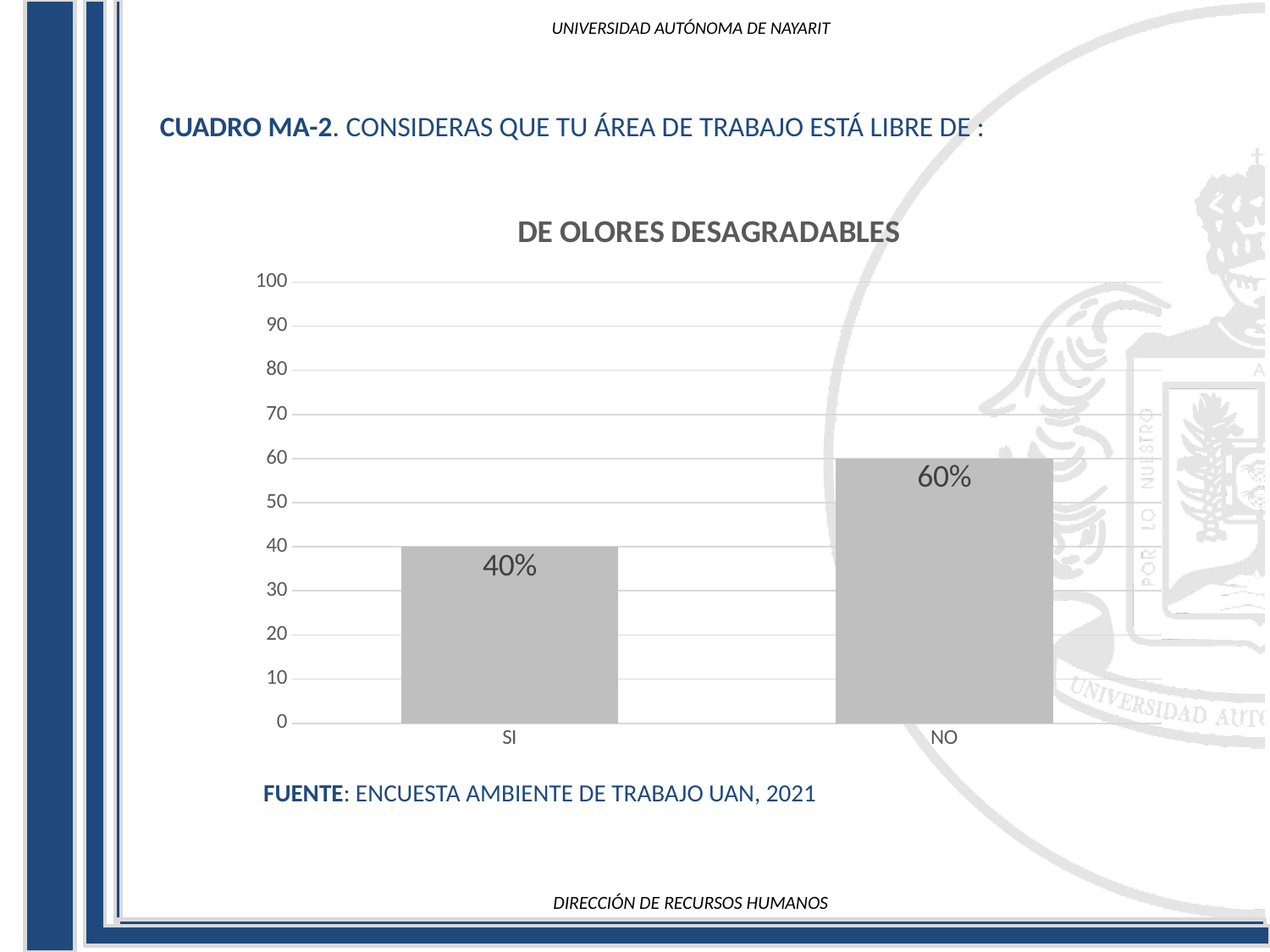
Is the value for SI greater or less than 50? less How many categories are shown on the x axis? 2 Which is larger, the value for SI or the value for NO? NO What is the difference between the values for NO and SI? 20% What kind of chart is shown on the slide? bar chart Which category has the highest value? NO Which category has the lowest value? SI Is the value for NO greater or less than 50? greater What is the value for SI? 40% What is the title of the chart? DE OLORES DESAGRADABLES What is the value for NO? 60% What is the maximum value shown on the y axis? 100